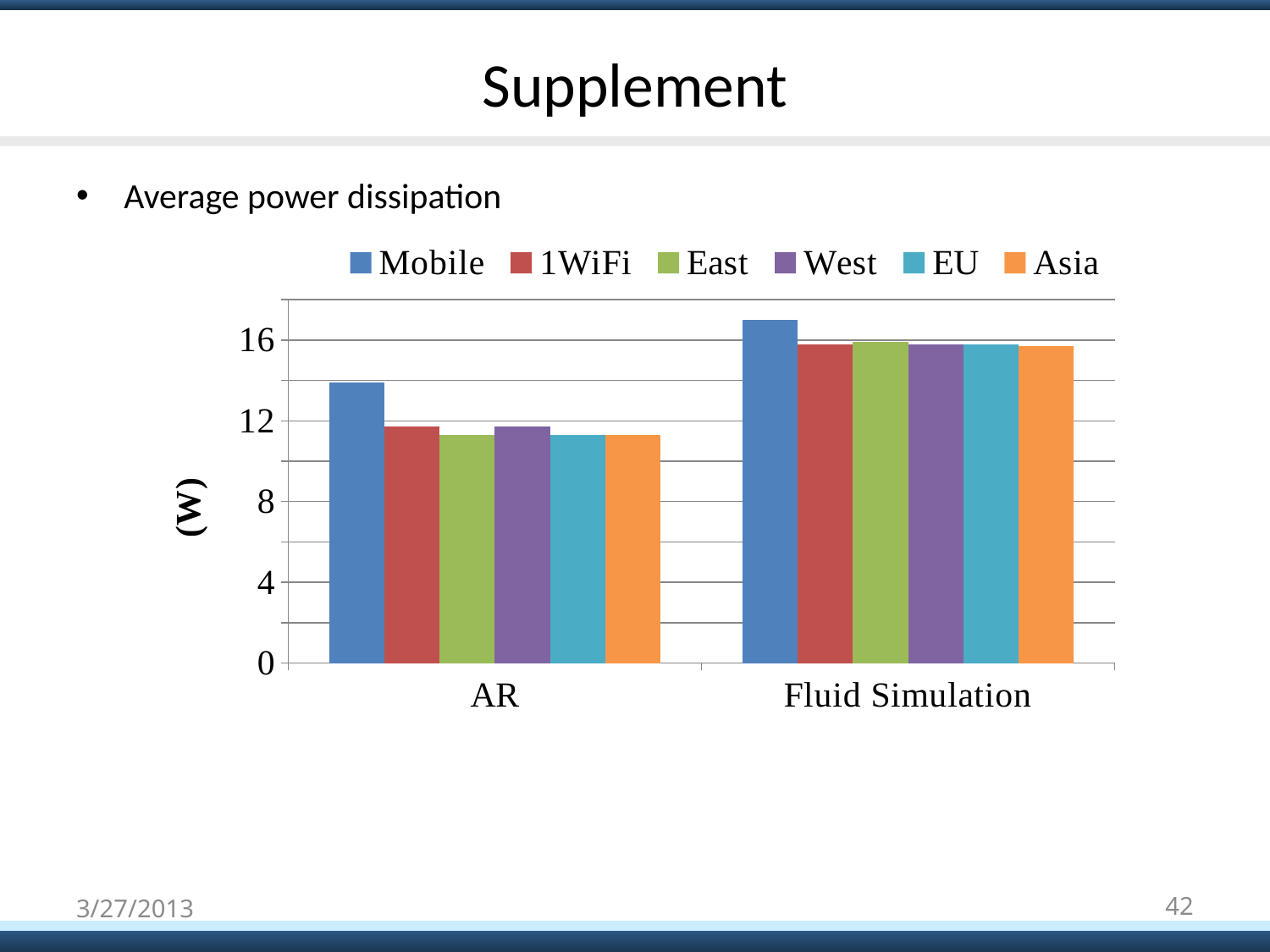
Is the value for Asia in the Fluid Simulation category greater or less than 12? greater What kind of chart is shown on the slide? bar chart How many series does the chart legend list? 6 Which is larger: the Mobile value for AR or the Mobile value for Fluid Simulation? Fluid Simulation Which is larger in the AR category: Mobile or EU? Mobile Which series has the highest value for the AR category? Mobile Is the value for Mobile in the AR category greater or less than 12? greater Is the value for East in the AR category greater or less than 12? less Which series has the highest value for the Fluid Simulation category? Mobile What is the label on the y axis of the chart? (W) How many categories are shown on the x axis of the chart? 2